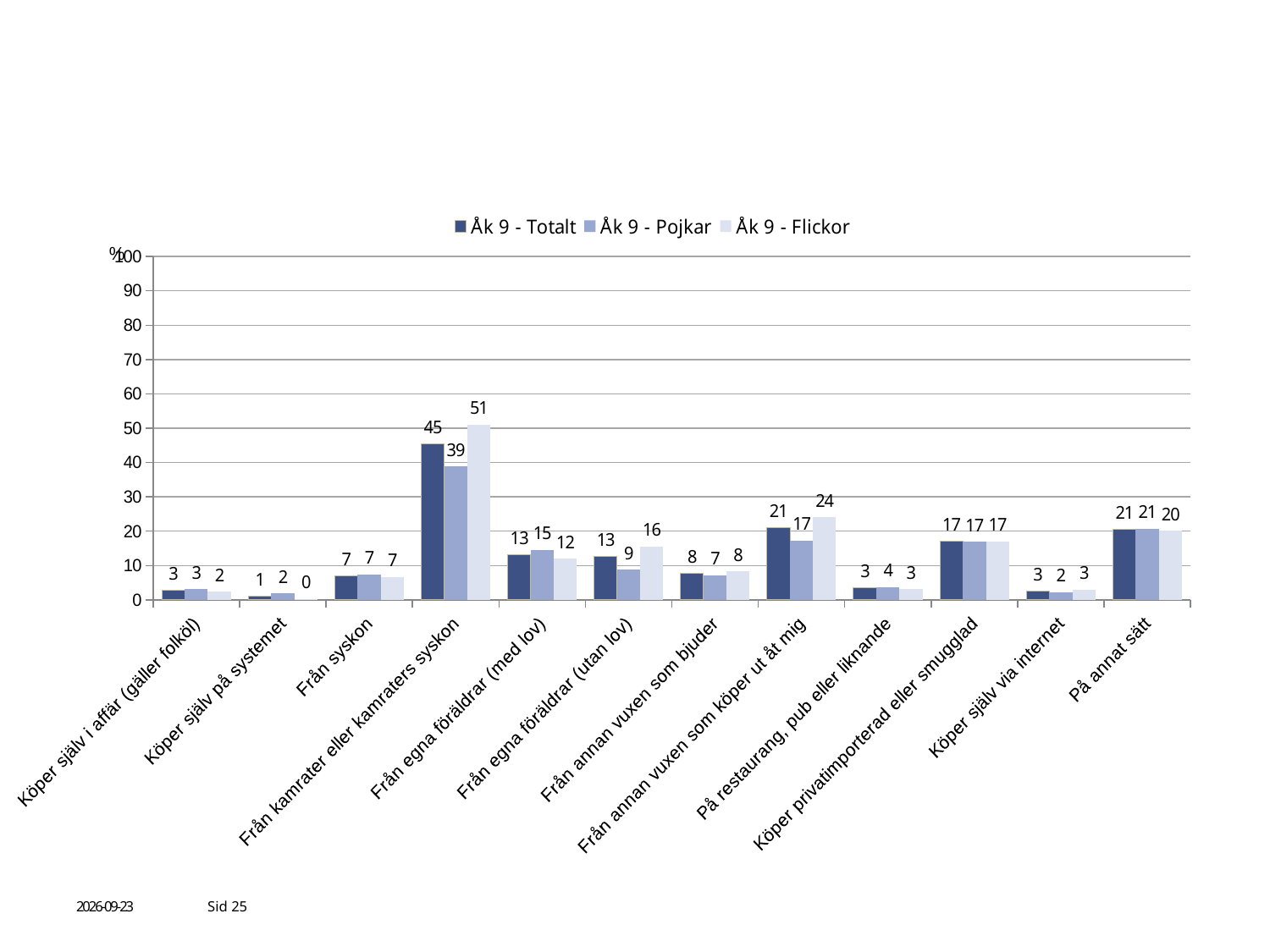
How many series does the legend list? 3 What is the value for Åk 9 - Totalt in the category 'Från annan vuxen som köper ut åt mig'? 21 What is the value for Åk 9 - Pojkar in the category 'Från egna föräldrar (utan lov)'? 9 What kind of chart is shown on the slide? bar chart What is the value for Åk 9 - Flickor in the category 'Från kamrater eller kamraters syskon'? 51 Which category has the highest value for Åk 9 - Totalt? Från kamrater eller kamraters syskon For 'Från egna föräldrar (med lov)', which is larger: the Åk 9 - Pojkar value or the Åk 9 - Flickor value? Åk 9 - Pojkar What are the three series listed in the legend? Åk 9 - Totalt, Åk 9 - Pojkar, Åk 9 - Flickor Which category has the lowest value for Åk 9 - Flickor? Köper själv på systemet How many categories are shown on the x axis? 12 What is the difference between the Åk 9 - Flickor and Åk 9 - Pojkar values for 'Från kamrater eller kamraters syskon'? 12 Is the Åk 9 - Totalt value for 'Från kamrater eller kamraters syskon' greater or less than 40? greater